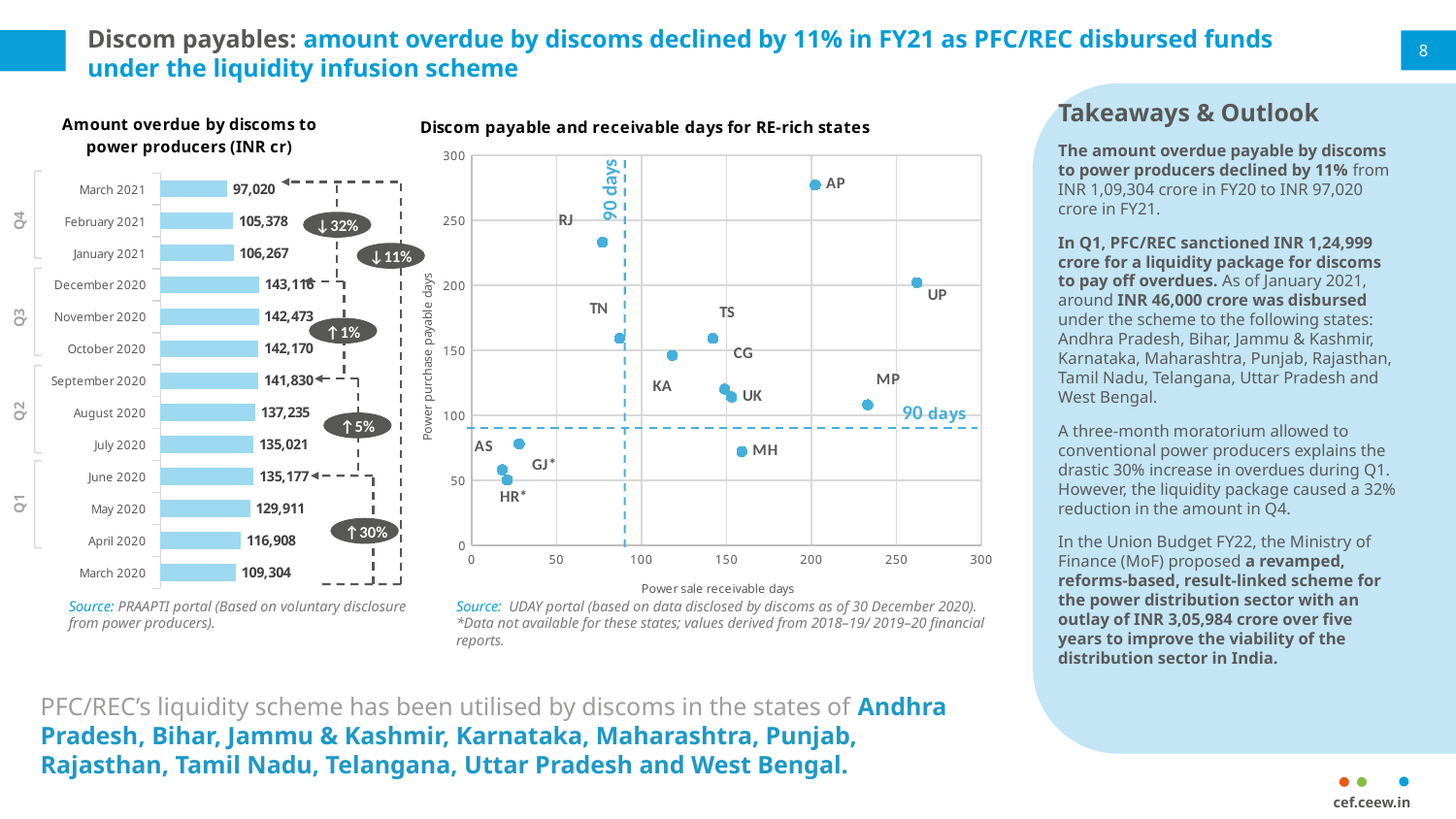
What kind of chart is 'Amount overdue by discoms to power producers (INR cr)'? Bar chart In the 'Amount overdue by discoms to power producers (INR cr)' chart, which is larger: the value for June 2020 or July 2020? June 2020 In the 'Amount overdue by discoms to power producers (INR cr)' chart, what is the difference between the values for December 2020 and March 2021? 46,096 In the 'Discom payable and receivable days for RE-rich states' chart, are the power sale receivable days for UP greater or less than 250? greater In the 'Discom payable and receivable days for RE-rich states' chart, which state has the highest power purchase payable days? AP In the 'Amount overdue by discoms to power producers (INR cr)' chart, what is the value for March 2021? 97,020 In the 'Amount overdue by discoms to power producers (INR cr)' chart, which month has the highest value? December 2020 In the 'Amount overdue by discoms to power producers (INR cr)' chart, which month has the lowest value? March 2021 In the 'Amount overdue by discoms to power producers (INR cr)' chart, what is the value for March 2020? 109,304 How many months are shown in the 'Amount overdue by discoms to power producers (INR cr)' chart? 13 What kind of chart is 'Discom payable and receivable days for RE-rich states'? Scatter chart In the 'Discom payable and receivable days for RE-rich states' chart, what is the label on the x axis? Power sale receivable days